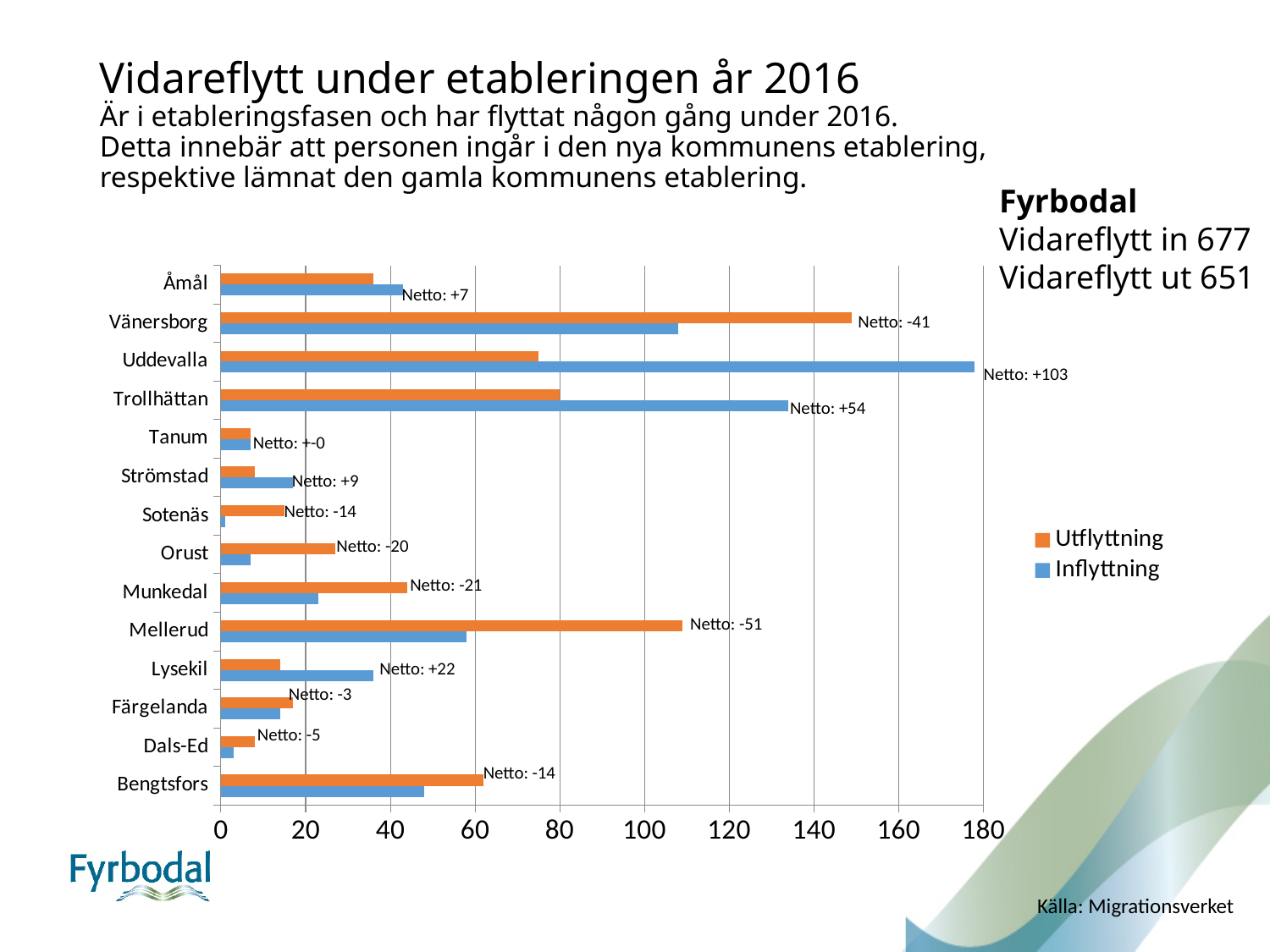
What kind of chart is shown on the slide? Bar chart What is the Netto value printed for Uddevalla? Netto: +103 How many series does the legend list? 2 Is the Utflyttning value for Trollhättan greater or less than 100? less Which municipality has the highest Utflyttning value? Vänersborg Which colour represents the Inflyttning series in the legend? Blue What is the Netto value printed for Lysekil? Netto: +22 How many municipalities are shown on the y axis of the chart? 14 For Mellerud, which is larger: Utflyttning or Inflyttning? Utflyttning What is the Netto value printed for Mellerud? Netto: -51 Which municipality has the highest Inflyttning value? Uddevalla Is the Inflyttning value for Uddevalla greater or less than 160? greater